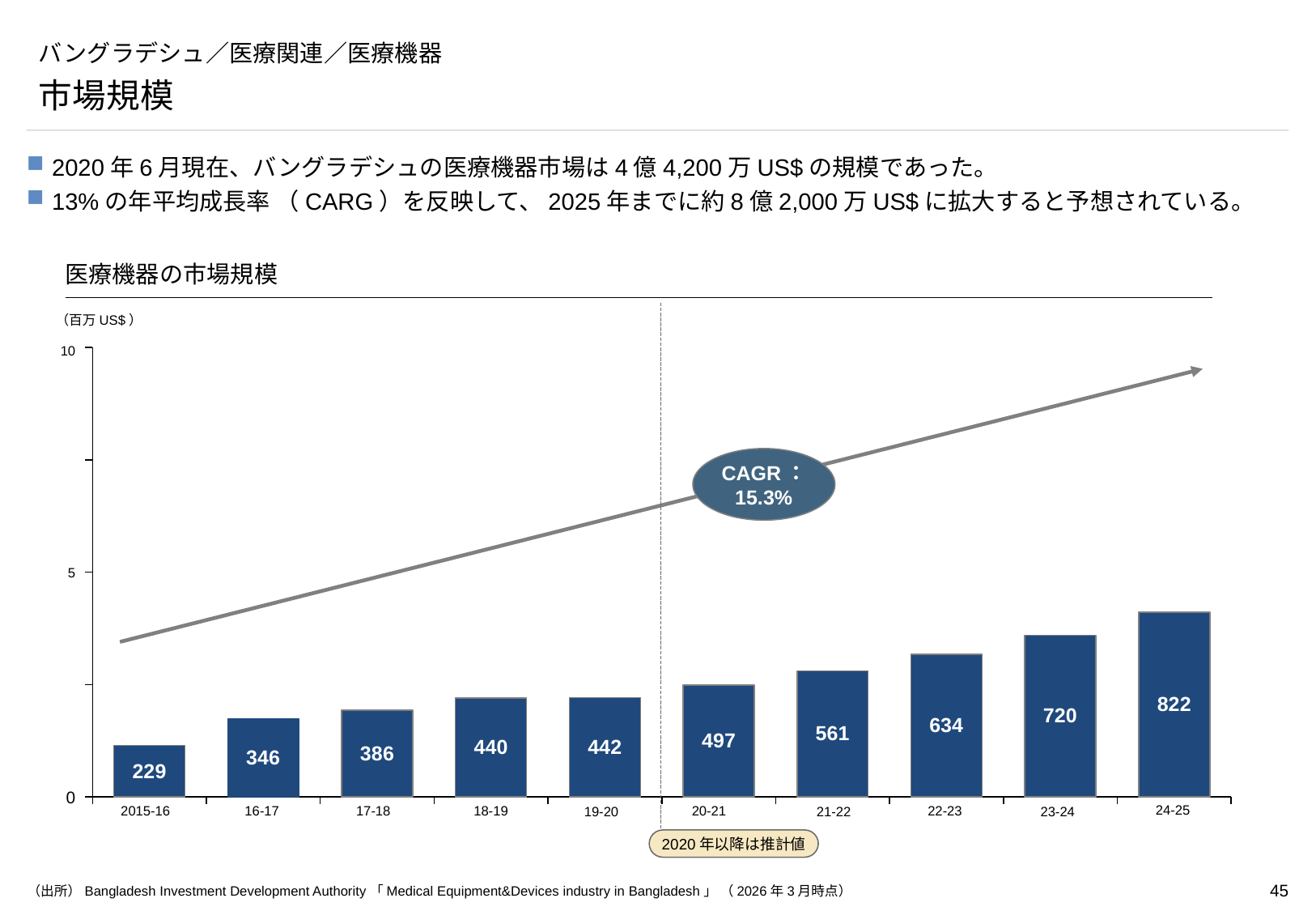
What CAGR is shown in the oval annotation on the 医療機器の市場規模 chart? 15.3% Do the values in the 医療機器の市場規模 chart rise or fall from 2015-16 to 24-25? rise What is the difference between the values for 24-25 and 23-24 in the 医療機器の市場規模 chart? 102 What is the difference between the values for 16-17 and 2015-16 in the 医療機器の市場規模 chart? 117 What is the value for 19-20 in the 医療機器の市場規模 chart? 442 Which category has the lowest value in the 医療機器の市場規模 chart? 2015-16 Which is larger in the 医療機器の市場規模 chart, the value for 20-21 or the value for 21-22? 21-22 How many categories are shown on the x axis of the 医療機器の市場規模 chart? 10 What is the value for 2015-16 in the 医療機器の市場規模 chart? 229 Which category has the highest value in the 医療機器の市場規模 chart? 24-25 What is the value for 22-23 in the 医療機器の市場規模 chart? 634 What kind of chart is the 医療機器の市場規模 chart? bar chart